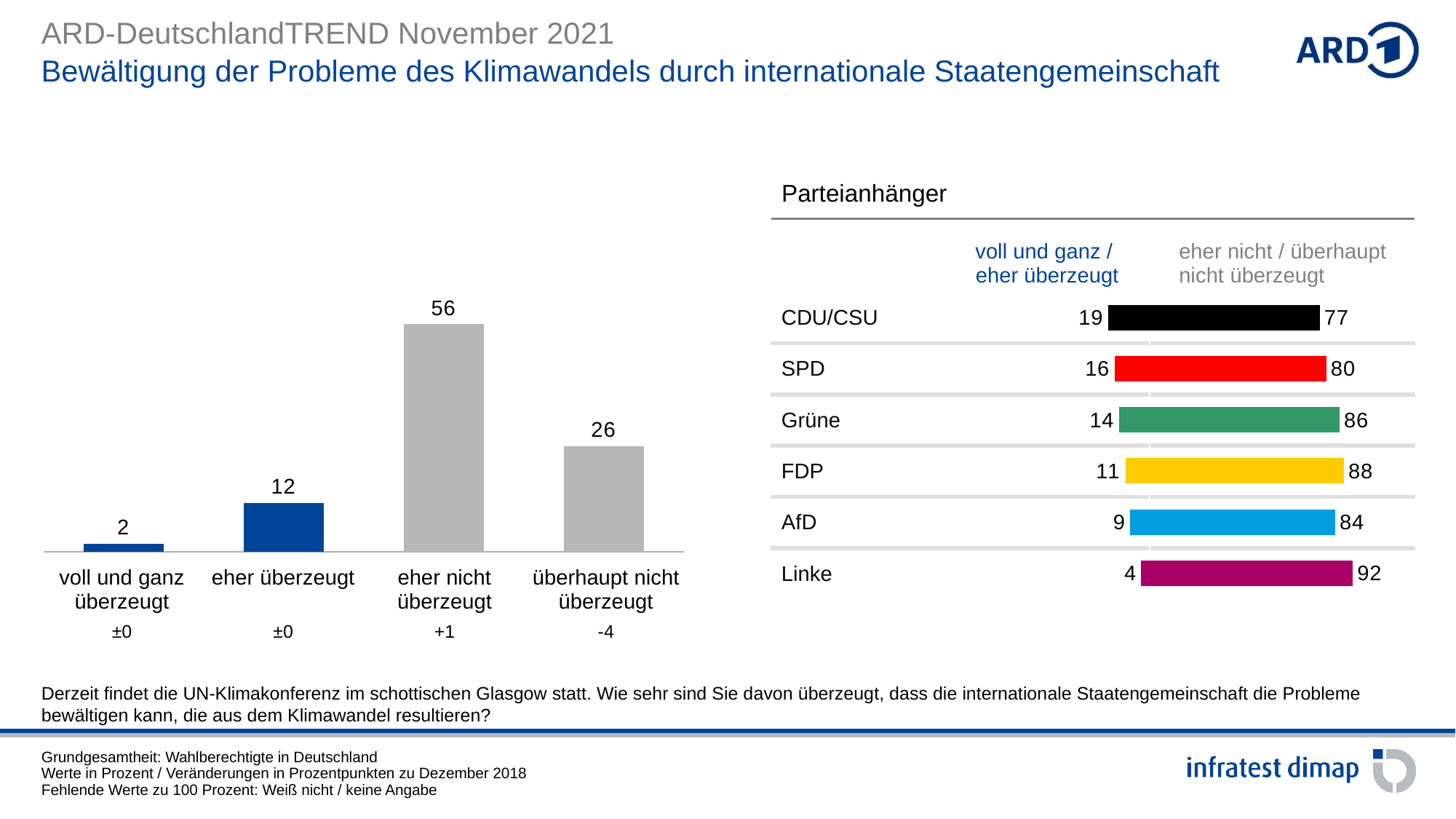
In the Parteianhänger chart, what is the "voll und ganz / eher überzeugt" value for CDU/CSU? 19 In the Parteianhänger chart, is the "voll und ganz / eher überzeugt" value larger for SPD or for Grüne? SPD In the left bar chart, which category has the lowest value? voll und ganz überzeugt In the left bar chart, what is the value for "voll und ganz überzeugt"? 2 What kind of chart is the left chart? bar chart In the left bar chart, which category has the highest value? eher nicht überzeugt In the Parteianhänger chart, what is the "eher nicht / überhaupt nicht überzeugt" value for Linke? 92 In the left bar chart, what is the difference between the values for "eher nicht überzeugt" and "überhaupt nicht überzeugt"? 30 In the left bar chart, what is the value for "eher nicht überzeugt"? 56 In the left bar chart, what change in percentage points is shown below "überhaupt nicht überzeugt"? -4 In the Parteianhänger chart, which party has the highest "eher nicht / überhaupt nicht überzeugt" value? Linke In the left bar chart, how many categories are shown? 4